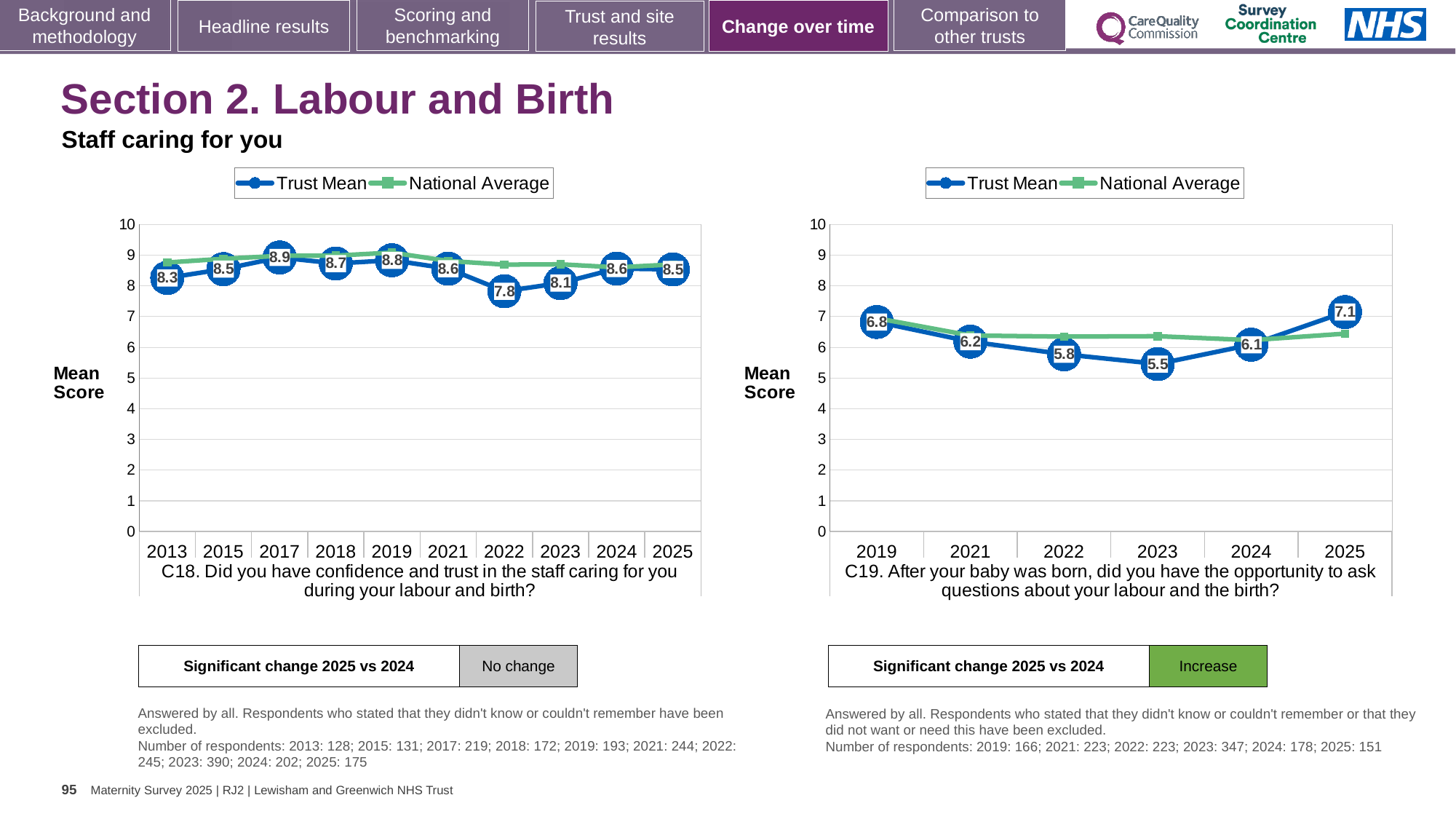
In the C18 chart (left), which year has the highest Trust Mean score? 2017 In the C19 chart (right), what is the Trust Mean score for 2025? 7.1 How many series does the legend of the C19 chart (right) list? 2 In the C19 chart (right), does the Trust Mean rise or fall from 2019 to 2023? Fall In the C18 chart (left), what is the Trust Mean score for 2017? 8.9 In the C18 chart (left), which is larger, the Trust Mean score for 2022 or for 2024? 2024 In the C19 chart (right), which year has the lowest Trust Mean score? 2023 In the C19 chart (right), is the National Average value for 2023 greater or less than 7? less In the C18 chart (left), what is the Trust Mean score for 2022? 7.8 What kind of chart is the C19 chart (right)? Line chart In the C19 chart (right), what is the difference between the Trust Mean scores for 2025 and 2024? 1.0 How many years are plotted on the x axis of the C18 chart (left)? 10